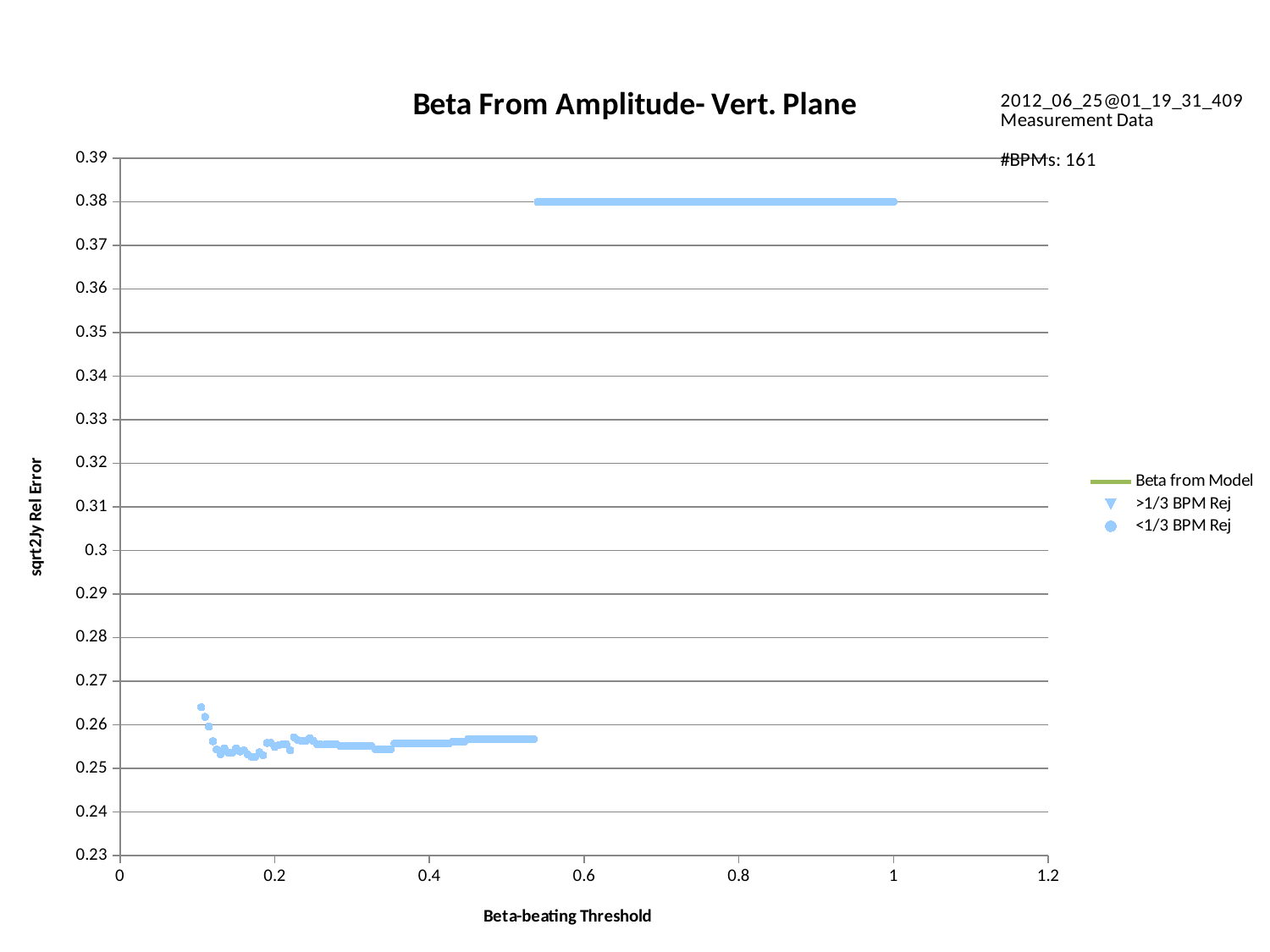
How many BPMs are stated on the slide? 161 What kind of chart is shown on the slide? scatter chart Is the value plotted at a Beta-beating Threshold of 0.3 greater or less than 0.26? less What y value do the plotted points between x = 0.6 and x = 1 lie on? 0.38 Which has the larger plotted value: the point at a Beta-beating Threshold of 0.8 or the point at 0.4? 0.8 Is the value plotted at a Beta-beating Threshold of 0.2 greater or less than 0.25? greater How many series does the legend list? 3 Is the value plotted at a Beta-beating Threshold of 0.8 greater or less than 0.37? greater What is the title of the chart? Beta From Amplitude- Vert. Plane